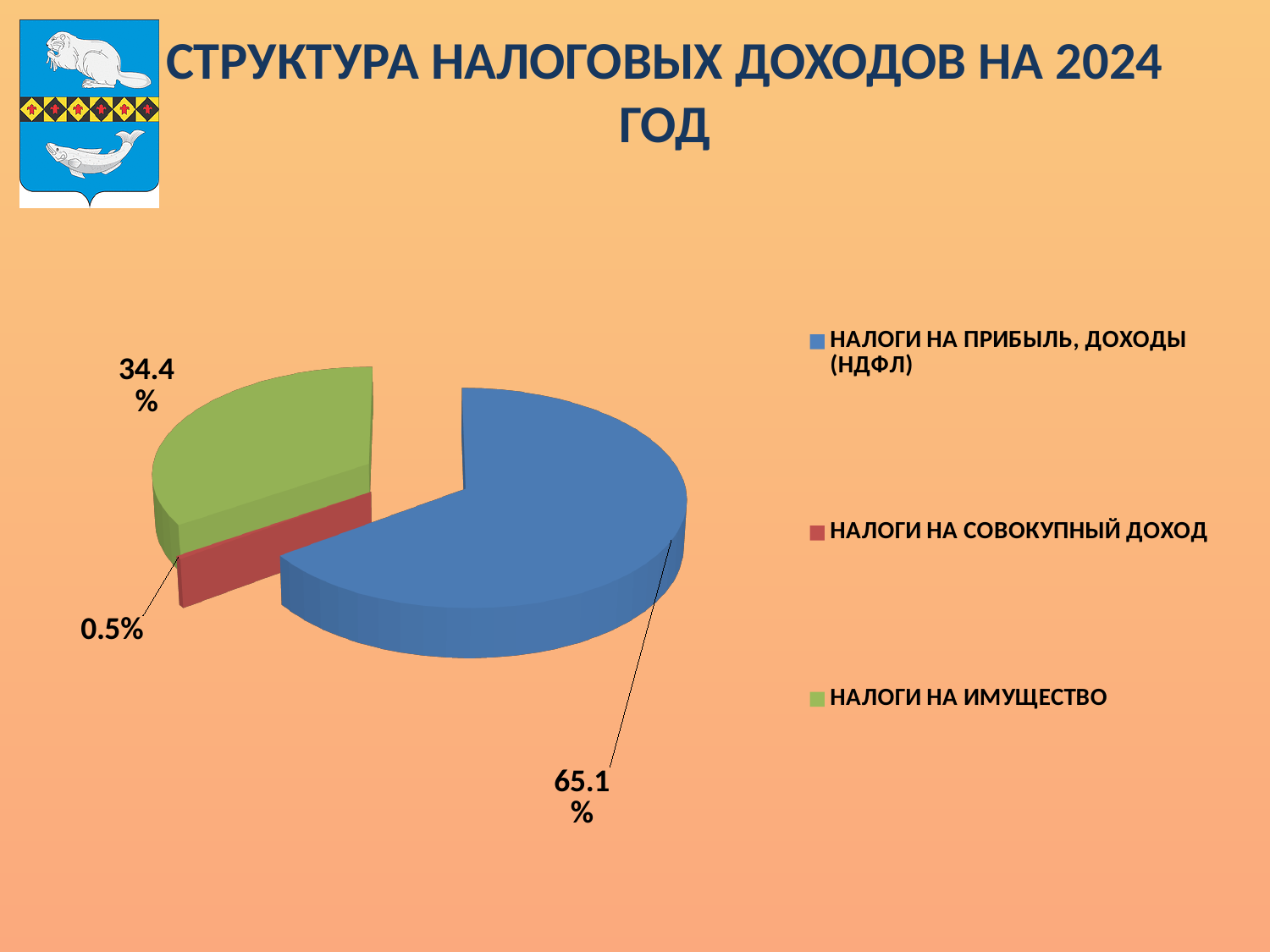
What is the title of the chart on the slide? СТРУКТУРА НАЛОГОВЫХ ДОХОДОВ НА 2024 ГОД Which category has the largest slice of the pie? НАЛОГИ НА ПРИБЫЛЬ, ДОХОДЫ (НДФЛ) How many categories are shown in the pie chart? 3 What share of the pie does НАЛОГИ НА ИМУЩЕСТВО have? 34.4% What share of the pie does НАЛОГИ НА ПРИБЫЛЬ, ДОХОДЫ (НДФЛ) have? 65.1% What kind of chart is shown on the slide? Pie chart Which is larger: the share for НАЛОГИ НА ИМУЩЕСТВО or the share for НАЛОГИ НА СОВОКУПНЫЙ ДОХОД? НАЛОГИ НА ИМУЩЕСТВО What colour is the slice for НАЛОГИ НА ИМУЩЕСТВО? Green What is the difference in percentage points between НАЛОГИ НА ПРИБЫЛЬ, ДОХОДЫ (НДФЛ) and НАЛОГИ НА ИМУЩЕСТВО? 30.7 Which category has the smallest slice of the pie? НАЛОГИ НА СОВОКУПНЫЙ ДОХОД What share of the pie does НАЛОГИ НА СОВОКУПНЫЙ ДОХОД have? 0.5%